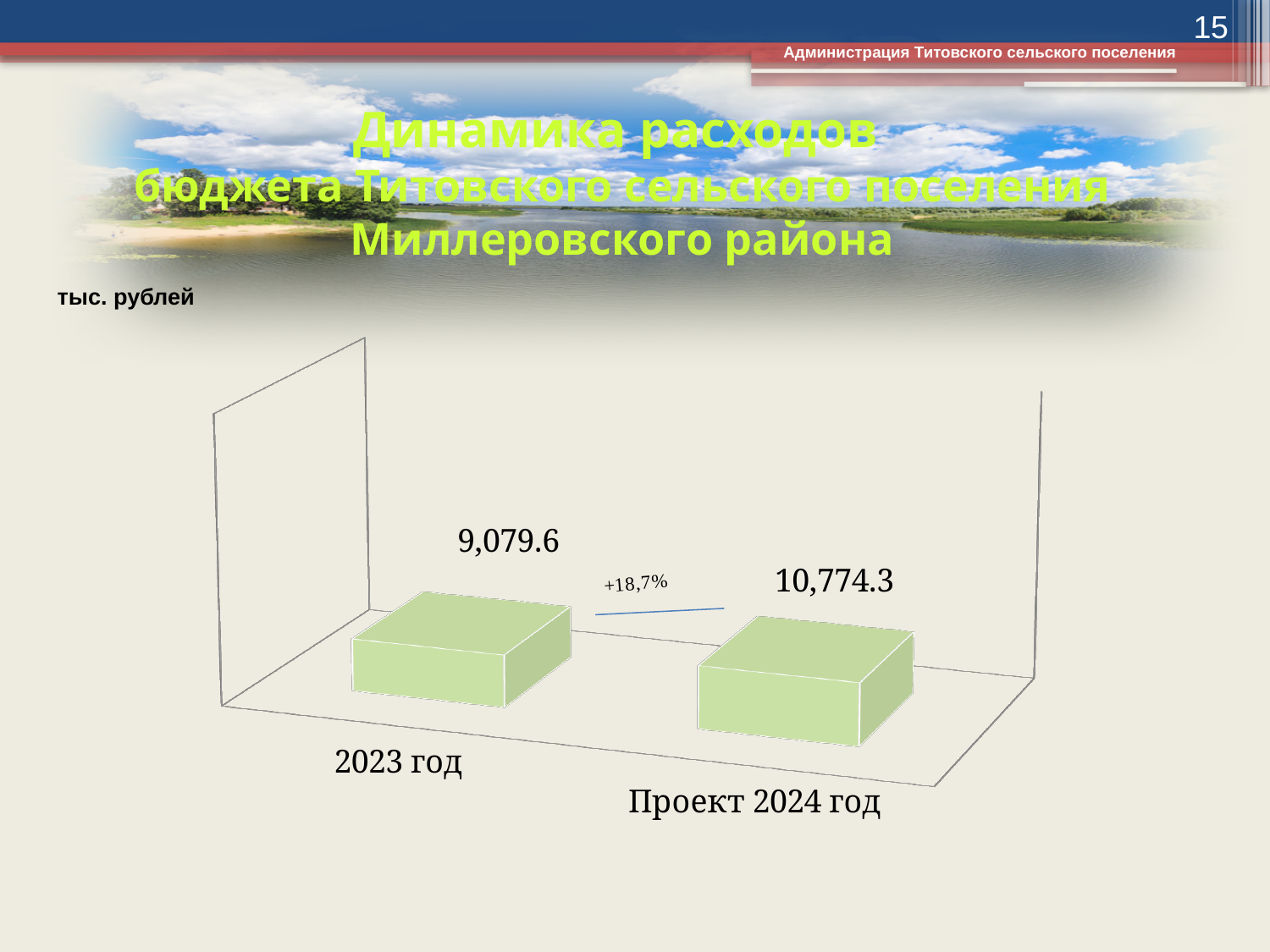
What unit of measurement is stated for the chart values? тыс. рублей How many categories are plotted on the chart? 2 What is the value shown for 2023 год? 9,079.6 What percentage change is annotated between the two bars? +18,7% Do the values rise or fall from 2023 год to Проект 2024 год? rise What is the value shown for Проект 2024 год? 10,774.3 Is the value for Проект 2024 год larger or smaller than the value for 2023 год? larger What kind of chart is shown on the slide? bar chart Which category has the lower value? 2023 год Which category has the higher value? Проект 2024 год What is the difference between the value for Проект 2024 год and the value for 2023 год? 1,694.7